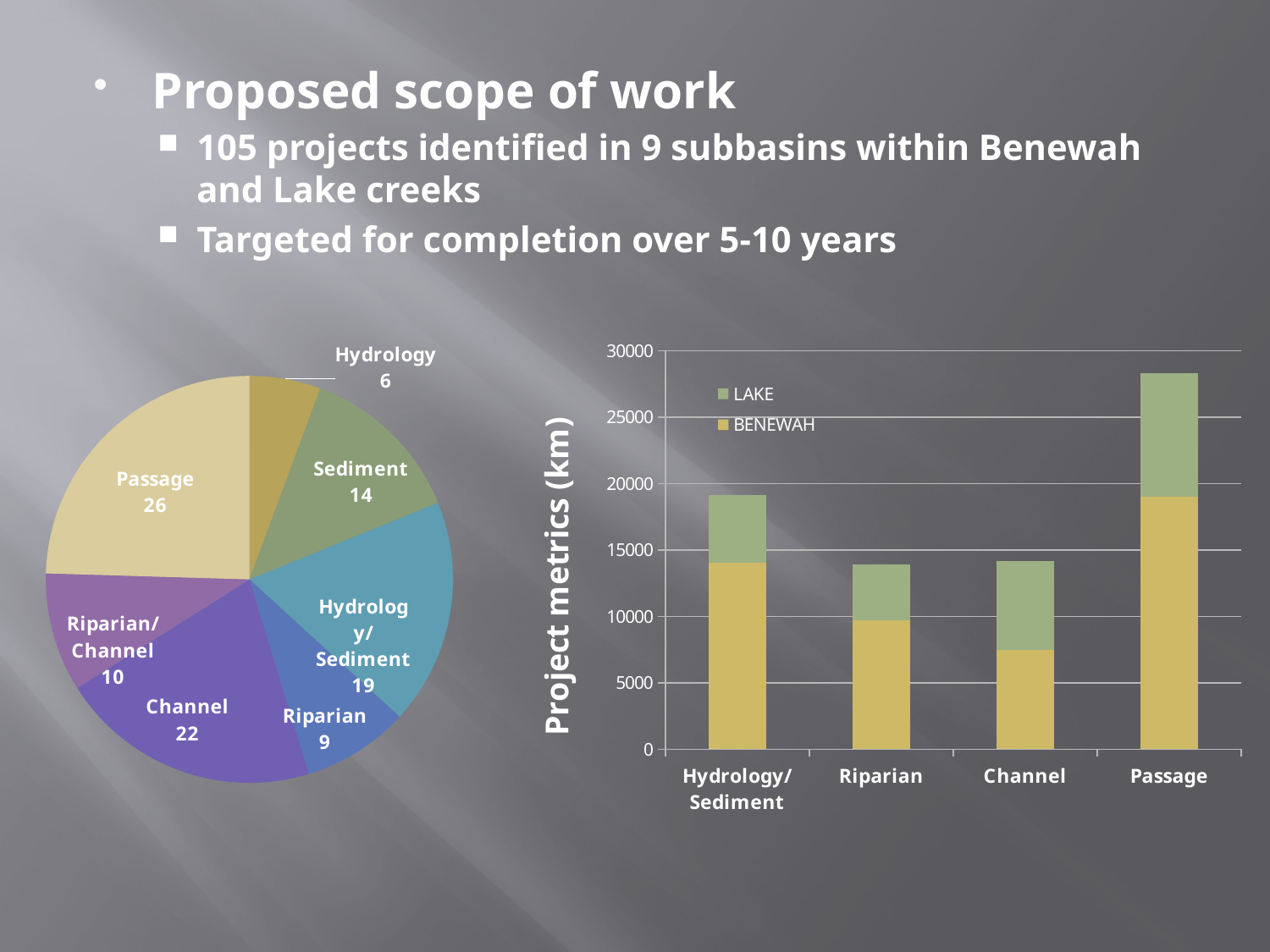
In the pie chart on the left, which is larger, Sediment or Riparian? Sediment In the pie chart on the left, how many projects are in the Passage category? 26 How many series does the legend of the bar chart on the right list? 2 In the pie chart on the left, which category has the smallest slice? Hydrology In the bar chart on the right, is the total stacked value for Passage greater or less than 25000? greater In the bar chart on the right, which category has the tallest stacked bar? Passage In the pie chart on the left, which category has the largest slice? Passage How many categories does the pie chart on the left show? 7 In the pie chart on the left, what is the value for Hydrology/Sediment? 19 In the pie chart on the left, what is the difference between the Passage and Channel values? 4 In the bar chart on the right, is the BENEWAH value for Channel greater or less than 10000? less What kind of chart is the chart on the right of the slide? Stacked bar chart